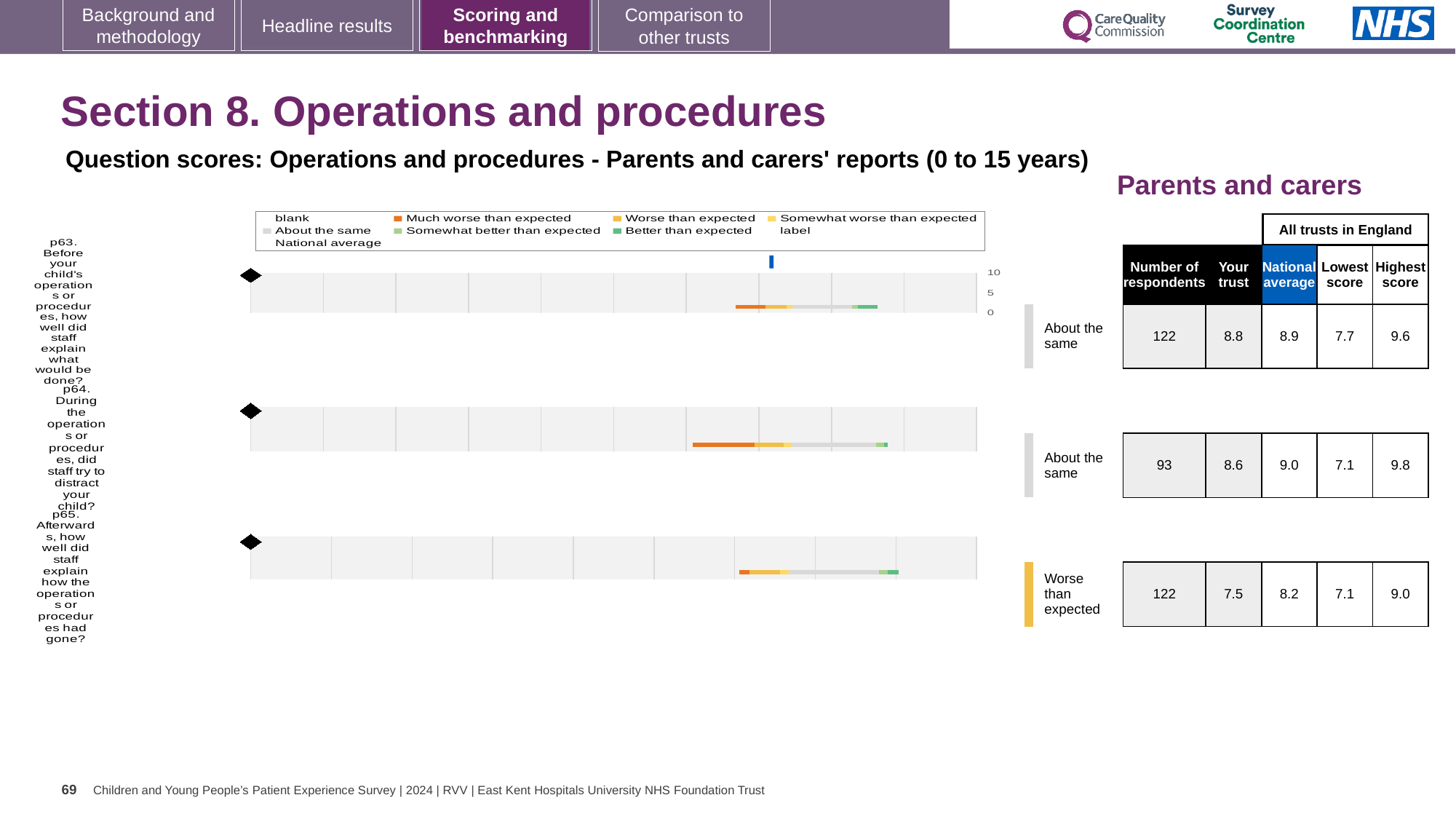
What is the difference between the highest and lowest scores for p64? 2.7 What is the national average score for p64 (did staff try to distract your child during the operation)? 9.0 What is the difference between the national average and the 'Your trust' score for p65? 0.7 How many respondents answered p64? 93 What is the highest score among all trusts in England for p65 (how well staff explained how the operation had gone)? 9.0 Which question has the highest 'Your trust' score? p63 Which question has the lowest 'Your trust' score? p65 What benchmark category is shown for p65? Worse than expected How many questions (charts) are shown on the slide? 3 For p63, which is larger: the 'Your trust' score or the national average? National average What is the 'Your trust' score for p63 (how well staff explained what would be done before the operation)? 8.8 What kind of chart is used to show the benchmarking results for p63, p64 and p65? bar chart